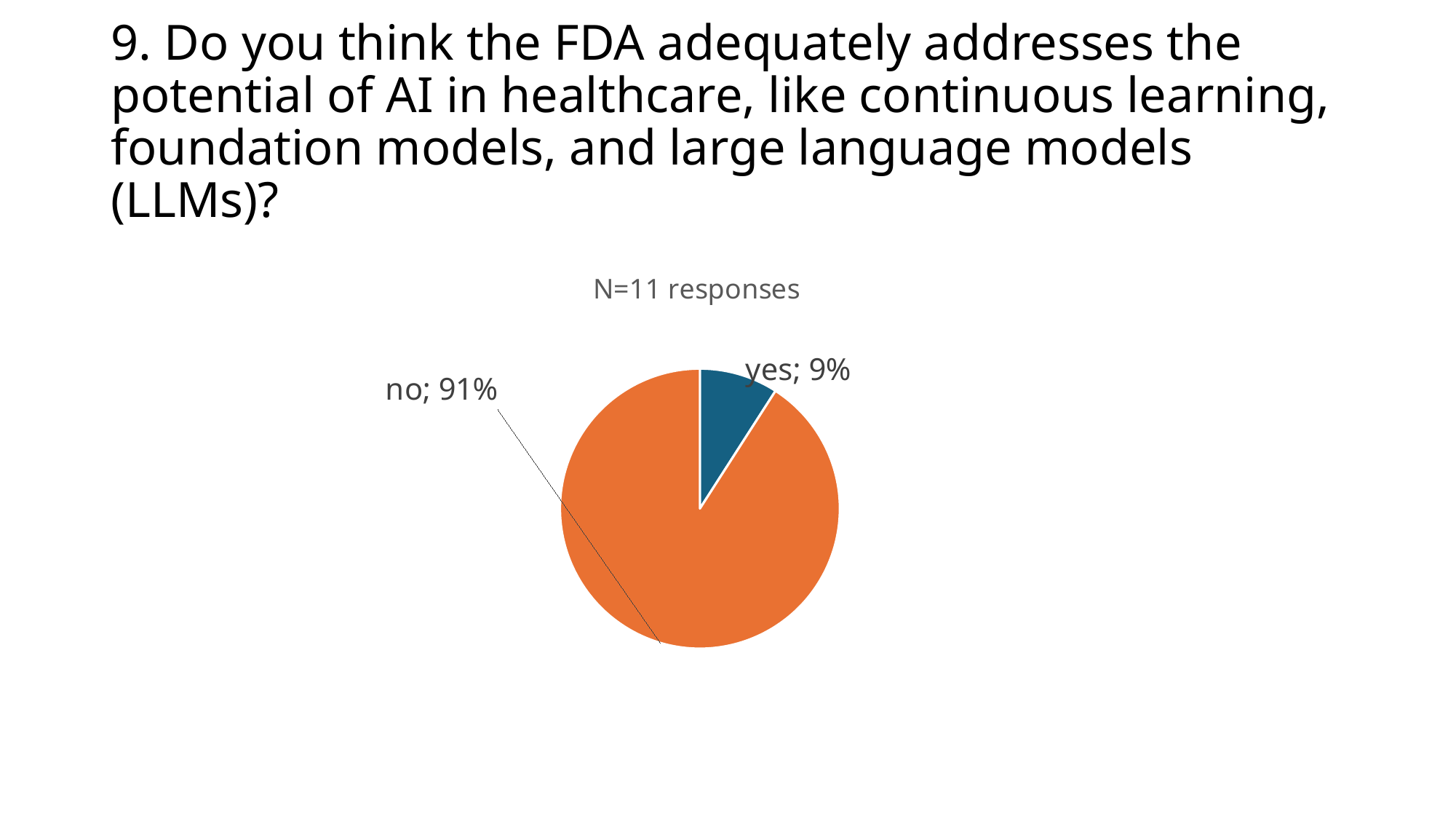
Which is larger, the share for "yes" or the share for "no"? no What is the difference in percentage points between the "no" and "yes" shares? 82 Which response has the smallest share of the pie? yes Which response has the largest share of the pie? no How many slices does the pie chart have? 2 What type of chart is shown on the slide? pie chart What is the chart's title? N=11 responses What share of responses is "no"? 91% What colour is the "yes" slice? blue What share of responses is "yes"? 9%